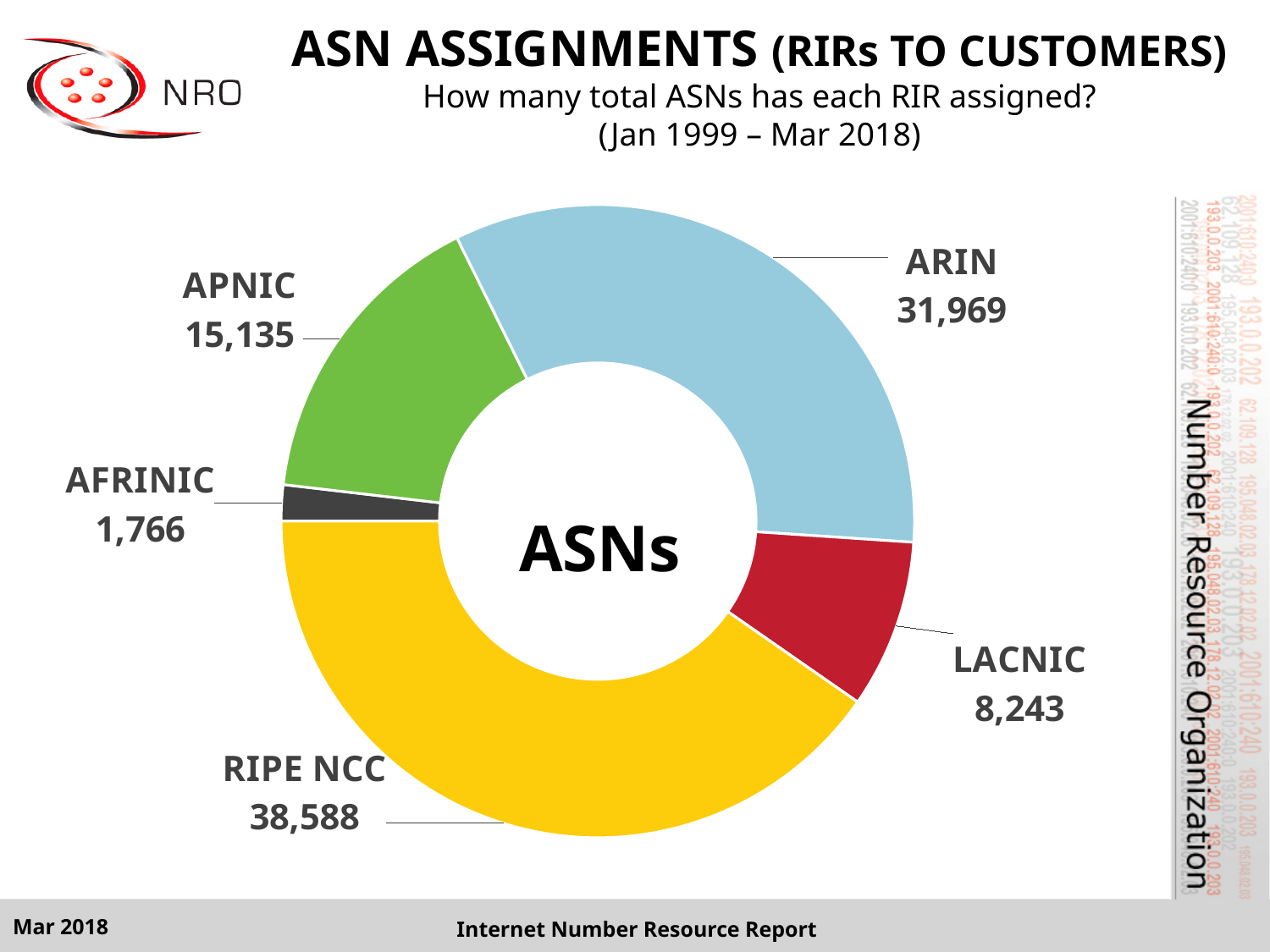
Which RIR has assigned the most ASNs? RIPE NCC What value is shown for LACNIC? 8,243 Which has assigned more ASNs, ARIN or APNIC? ARIN What is the total number of ASNs across all five RIRs shown? 95,701 How many ASNs has ARIN assigned according to the chart? 31,969 How many ASNs has AFRINIC assigned? 1,766 What is the difference between the RIPE NCC and ARIN values? 6,619 Which RIR has assigned the fewest ASNs? AFRINIC What colour is the RIPE NCC slice? Yellow What kind of chart is shown on the slide? Pie chart (donut) How many RIRs are shown in the chart? 5 What is the value shown for RIPE NCC? 38,588